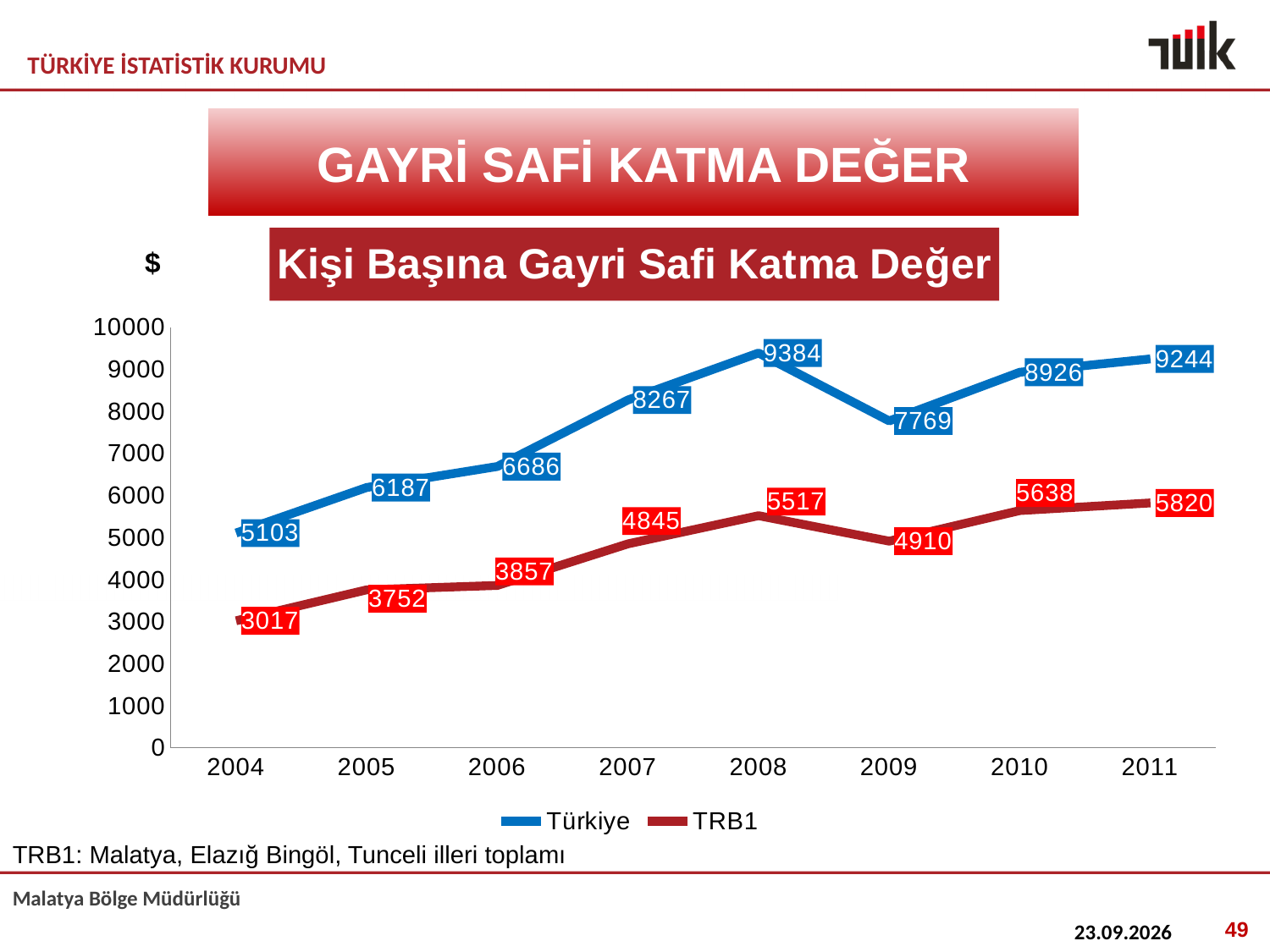
In which year is the Türkiye series highest? 2008 What is the title of the chart? Kişi Başına Gayri Safi Katma Değer How many years are shown on the x axis? 8 Which is larger: the TRB1 value in 2008 or the TRB1 value in 2009? 2008 What is the value for Türkiye in 2008? 9384 How many series does the legend list? 2 What kind of chart is shown? line chart What is the difference between the Türkiye and TRB1 values in 2011? 3424 In which year is the TRB1 series lowest? 2004 What is the value for TRB1 in 2011? 5820 What is the value for TRB1 in 2004? 3017 Is the Türkiye value for 2007 greater or less than 8000? greater